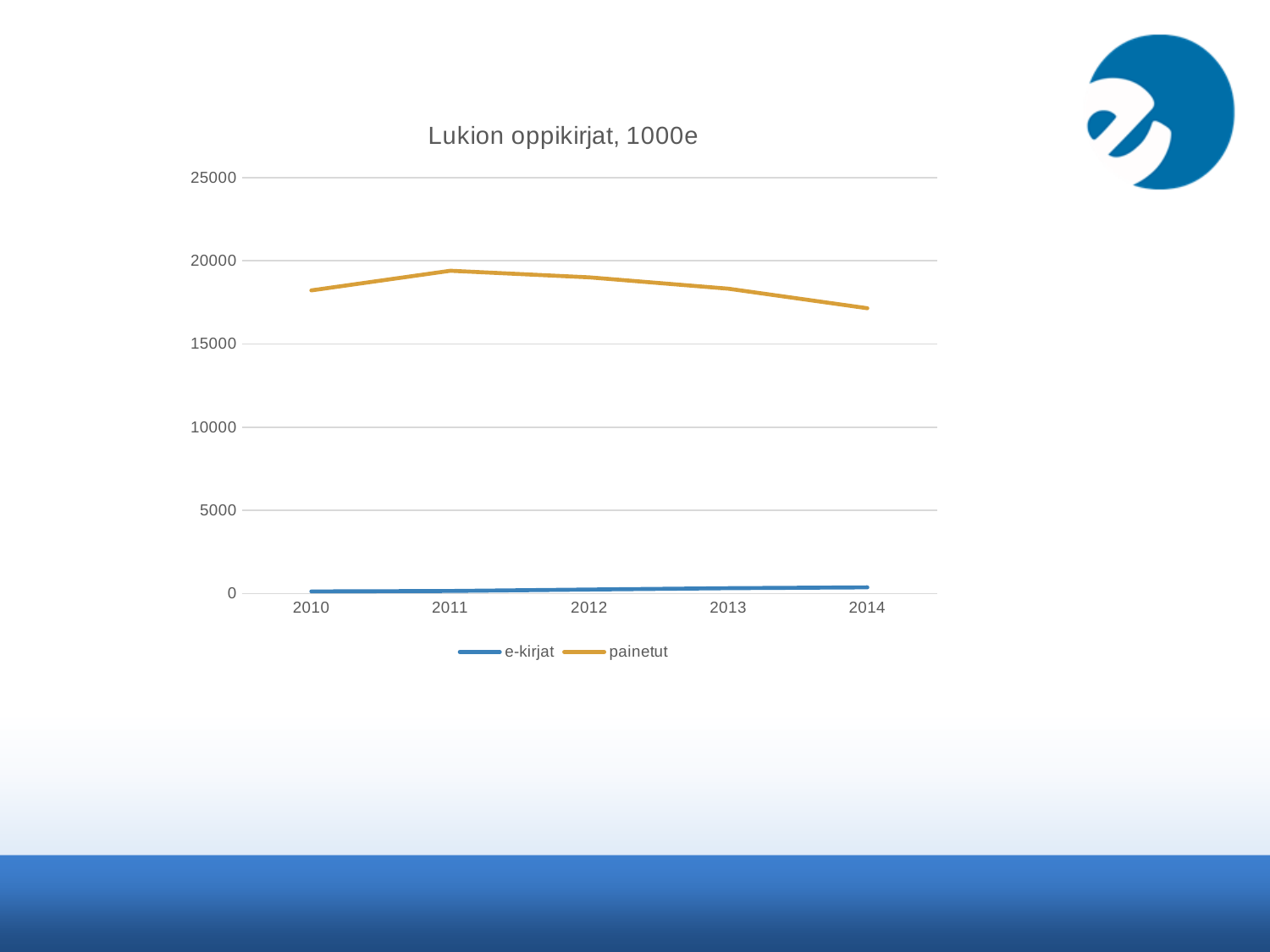
How many series does the legend list? 2 In which year is the value for painetut highest? 2011 Is the value for painetut in 2011 greater or less than 20000? less How many years are shown on the x axis? 5 Which series is drawn in orange? painetut Is the value for e-kirjat in 2014 greater or less than 5000? less Is the value for painetut in 2014 greater or less than 15000? greater What is the title of the chart? Lukion oppikirjat, 1000e In which year is the value for painetut lowest? 2014 What kind of chart is shown on the slide? line chart Which series has the larger value in 2012, e-kirjat or painetut? painetut Does the value for painetut rise or fall from 2011 to 2014? fall